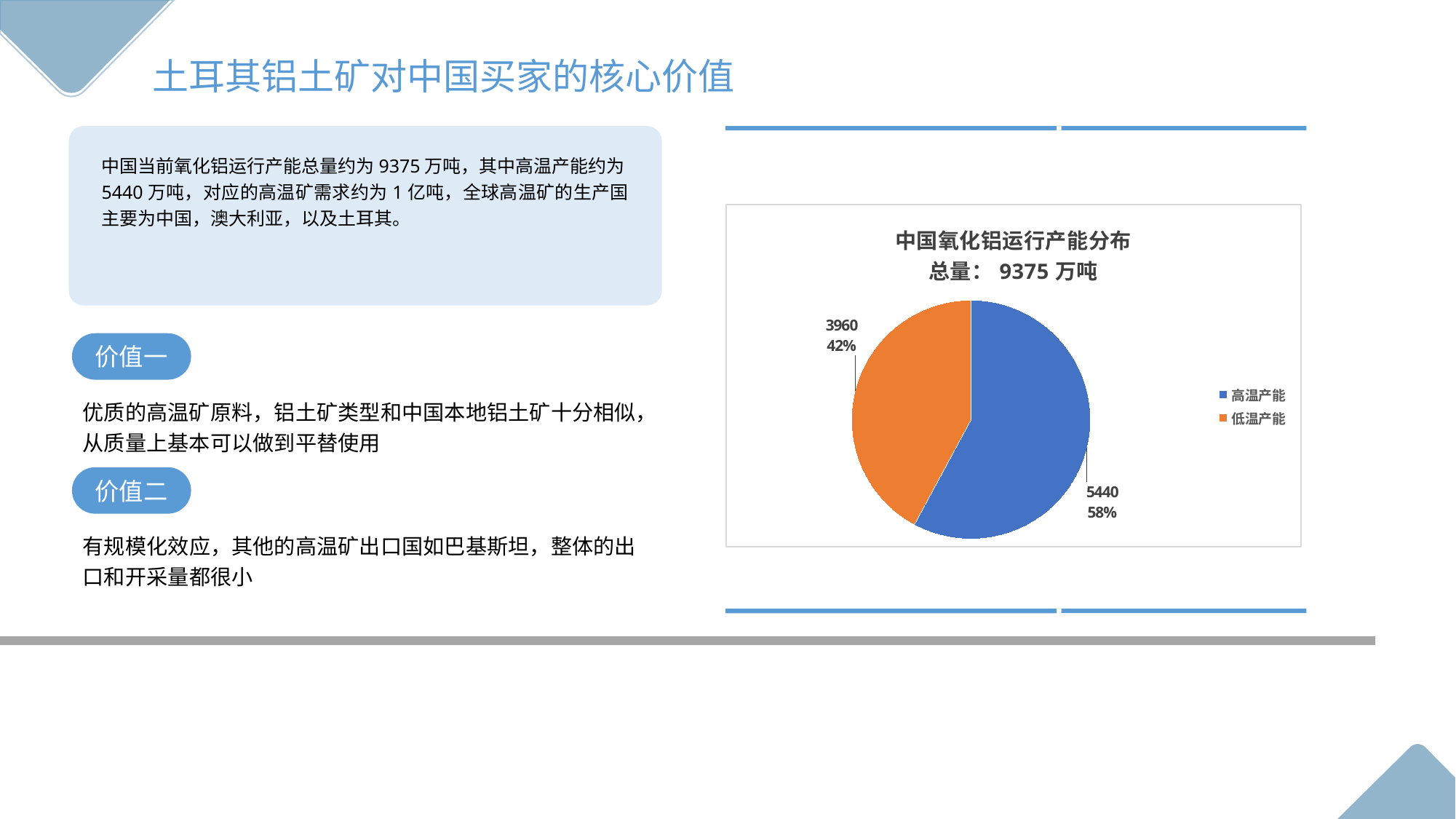
Which is larger, 高温产能 or 低温产能? 高温产能 What kind of chart is shown on the slide? pie chart What is the difference between the values for 高温产能 and 低温产能? 1480 What colour is the 低温产能 slice in the pie chart? orange Which category has the smallest slice in the pie chart? 低温产能 What share of the pie does 低温产能 represent? 42% What is the title of the pie chart? 中国氧化铝运行产能分布 总量：9375 万吨 What is the value for 低温产能 in the pie chart? 3960 Which category has the largest slice in the pie chart? 高温产能 What share of the pie does 高温产能 represent? 58% What is the value for 高温产能 in the pie chart? 5440 How many slices does the pie chart have? 2